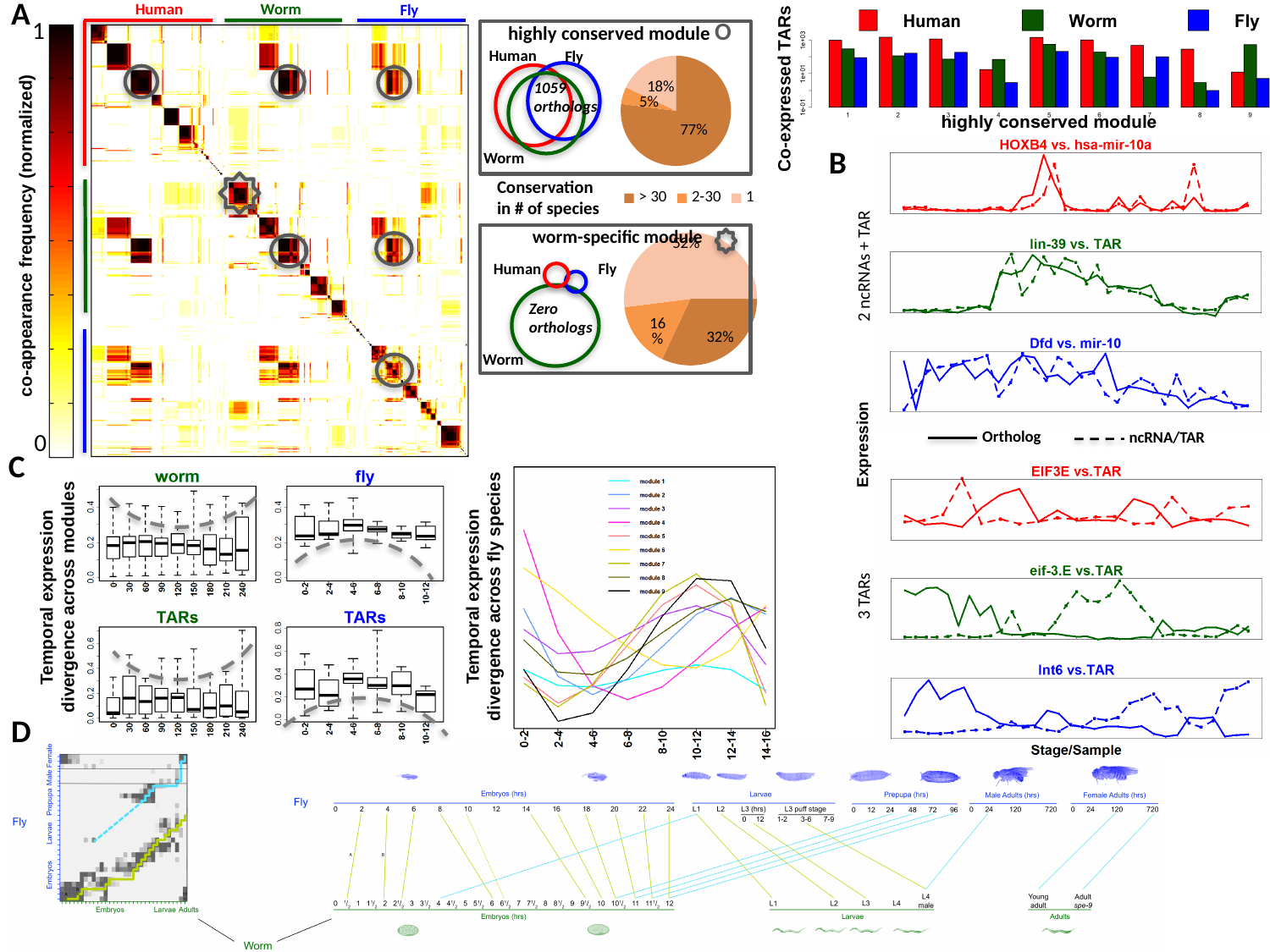
In the 'Co-expressed TARs' bar chart at the top right, is the Human bar for module 1 taller or shorter than the Fly bar for module 1? taller In the 'Co-expressed TARs' bar chart at the top right, how many modules are shown on the x axis? 9 In the 'Co-expressed TARs' bar chart at the top right, which species has the shortest bar for module 4? Fly In the 'highly conserved module' pie chart, what is the largest slice's percentage? 77% What kind of chart is the 'Co-expressed TARs' plot at the top right of the slide? bar chart In the 'Co-expressed TARs' bar chart at the top right, how many series does the legend list? 3 In the 'worm-specific module' pie chart, what is the largest slice's percentage? 52% In the 'worm-specific module' pie chart, what is the difference between the 52% slice and the 16% slice? 36% In the 'Co-expressed TARs' bar chart at the top right, which species has the tallest bar for module 8? Worm In the line chart of temporal expression divergence across fly species (panel C, right), how many modules does the legend list? 9 In the 'highly conserved module' pie chart, what is the smallest slice's percentage? 5% How many slices does the 'worm-specific module' pie chart have? 3